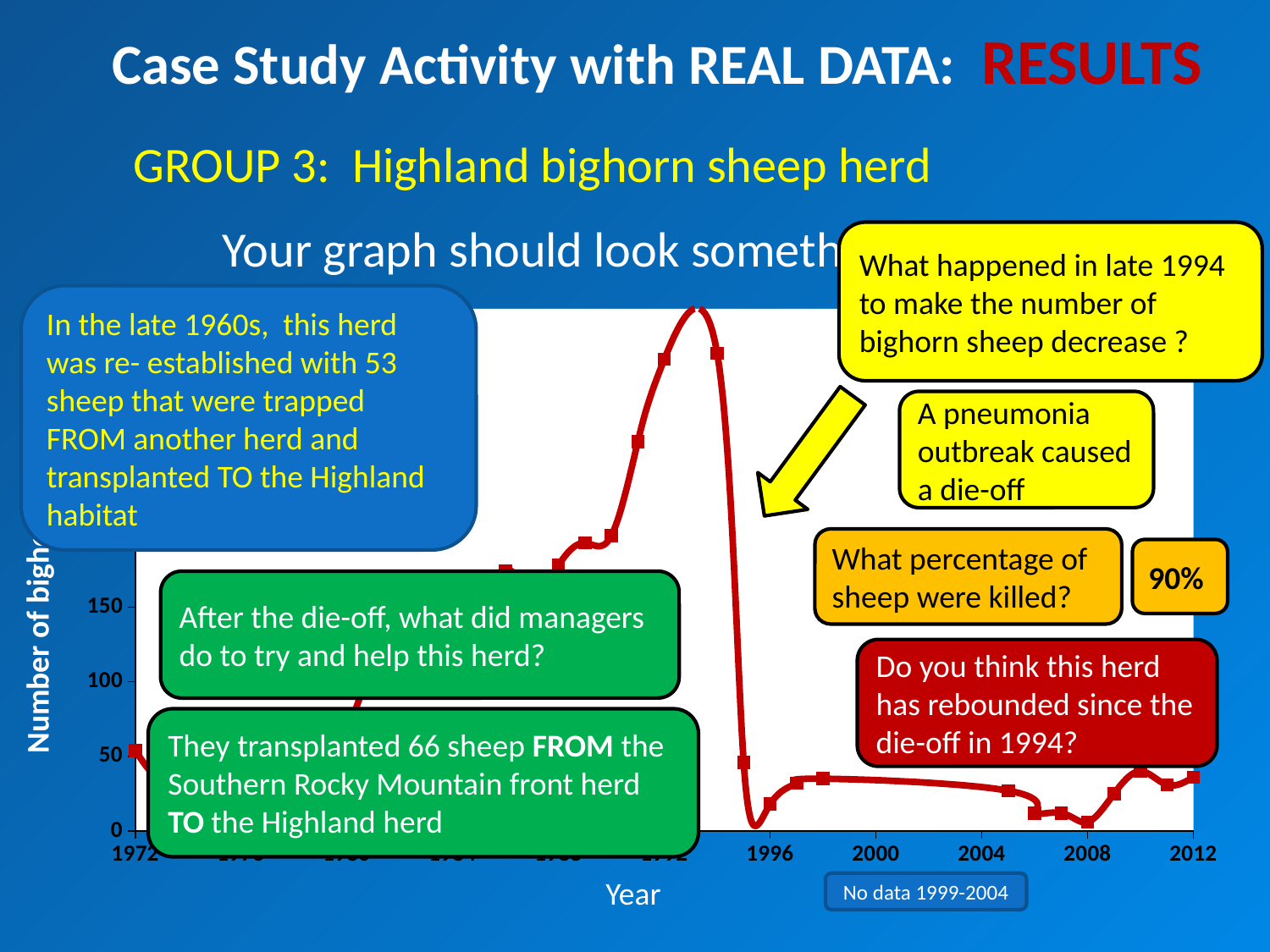
What is the label on the x axis of the chart? Year Which is larger, the value for 2008 or the value for 2012? 2012 Is the peak value of the line greater or less than 150? greater Is the value for 1996 greater or less than 50? less What kind of chart is shown on the slide? line chart Do the values rise or fall from 2008 to 2012? rise Is the value for 2012 greater or less than 50? less According to the note below the chart, for which years is there no data? 1999-2004